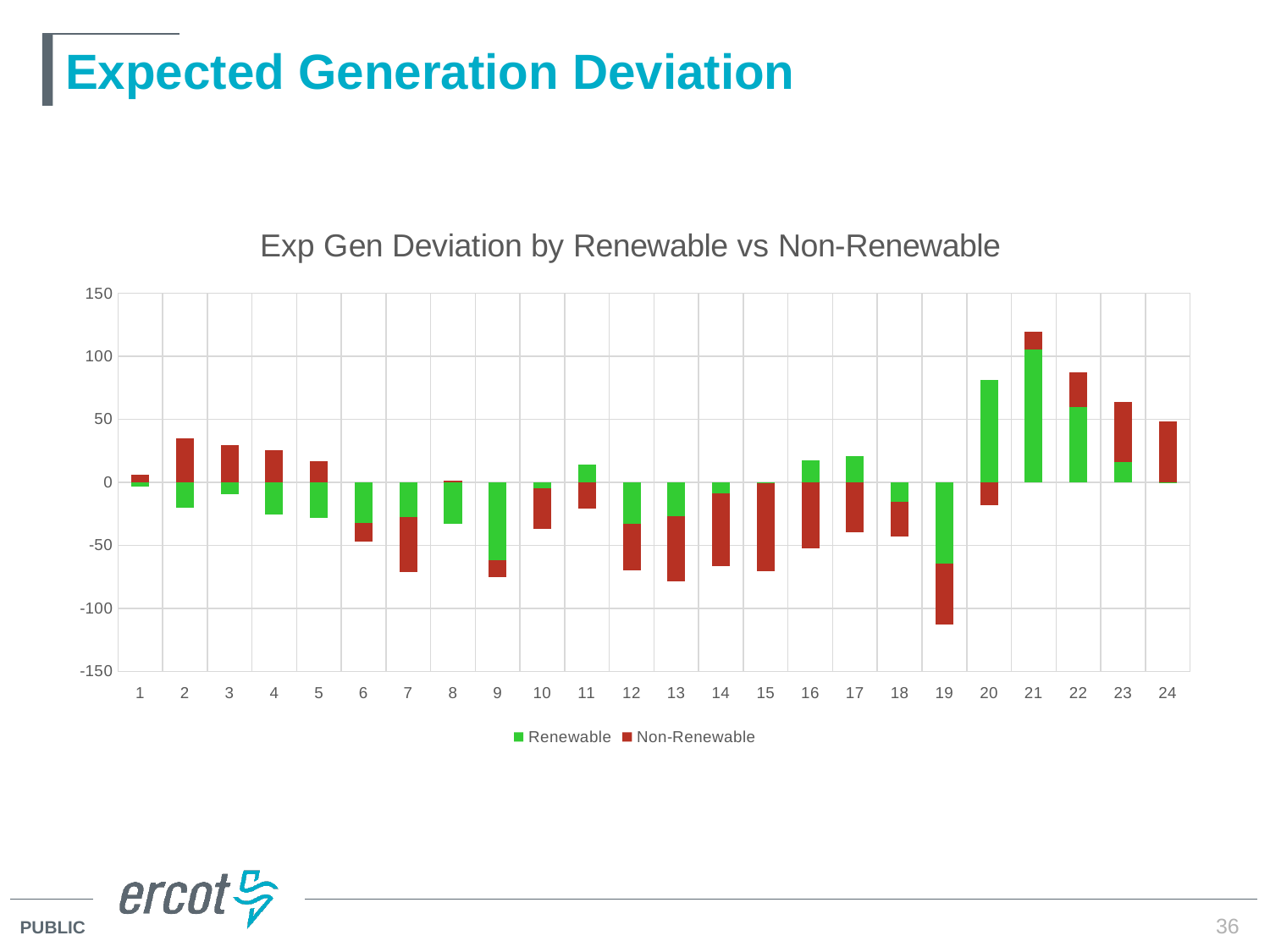
Is the Non-Renewable value for category 19 greater or less than -100? greater How many series does the legend list? 2 Which is larger, the Renewable value for category 20 or for category 23? Category 20 Which colour represents the Renewable series? Green What is the title of the chart? Exp Gen Deviation by Renewable vs Non-Renewable What kind of chart is shown on the slide? Stacked bar chart Which category has the lowest Non-Renewable value? 15 Is the Non-Renewable value for category 15 greater or less than -50? less Is the Renewable value for category 21 greater or less than 100? greater Which category has the highest Renewable value? 21 How many categories are shown along the x axis? 24